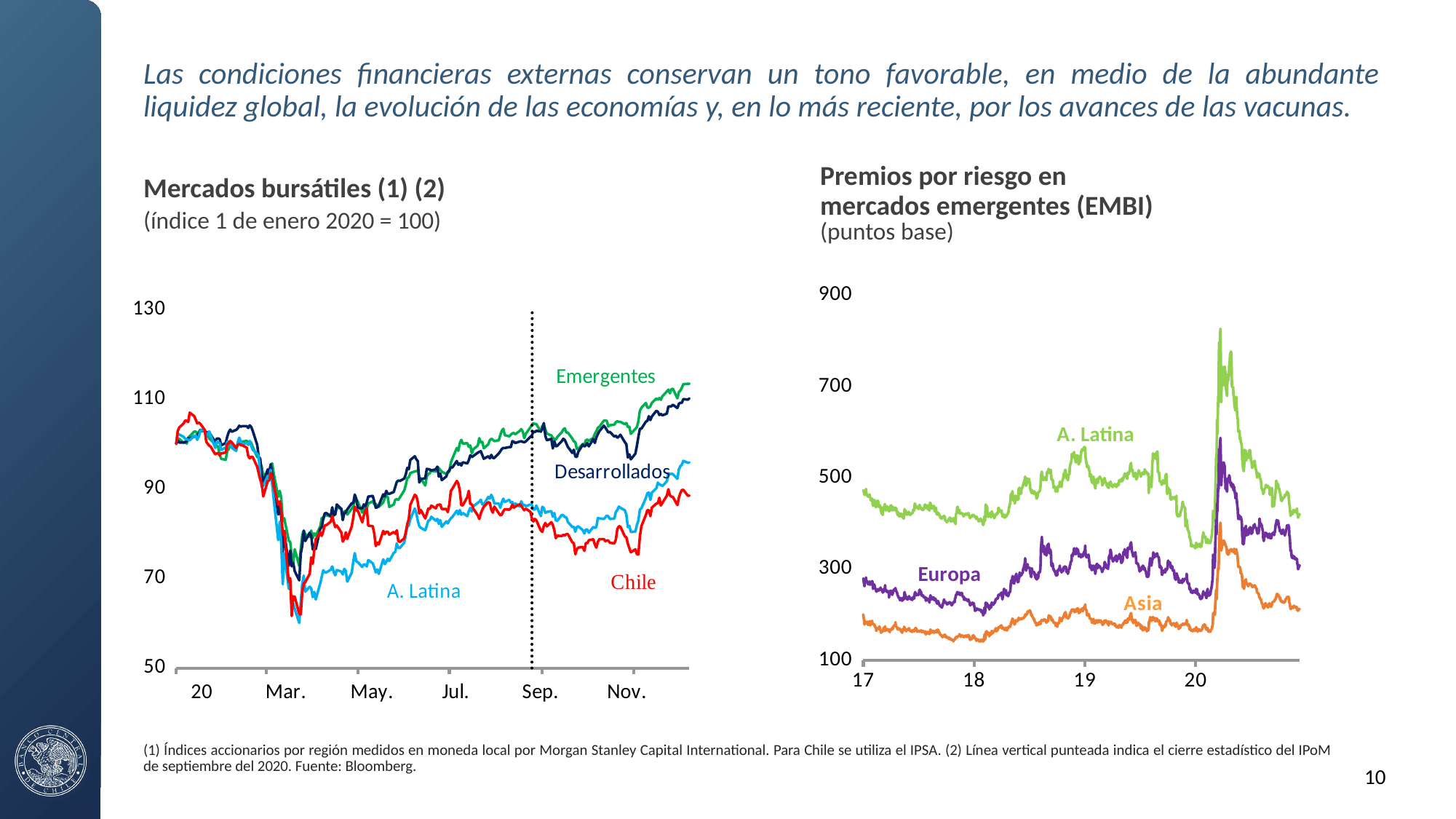
On the 'Premios por riesgo en mercados emergentes (EMBI)' chart, does the A. Latina series rise or fall from its 2020 peak to the end of the period? fall On the 'Premios por riesgo en mercados emergentes (EMBI)' chart, which series is the highest throughout the period? A. Latina What kind of chart is the 'Mercados bursátiles' chart on the left? line chart What unit is shown in the subtitle of the 'Premios por riesgo en mercados emergentes (EMBI)' chart? puntos base On the 'Mercados bursátiles' chart, which series is the highest at the end of the period (Nov.)? Emergentes On the 'Premios por riesgo en mercados emergentes (EMBI)' chart, which series is the lowest at the end of the period? Asia On the 'Mercados bursátiles' chart, is the lowest value reached by A. Latina in March greater or less than 70? less How many series are plotted on the 'Premios por riesgo en mercados emergentes (EMBI)' chart on the right? 3 On the 'Premios por riesgo en mercados emergentes (EMBI)' chart, is the peak value for A. Latina in 2020 greater or less than 700? greater How many series are plotted on the 'Mercados bursátiles' chart on the left? 4 On the 'Mercados bursátiles' chart, which series is the lowest at the end of the period (Nov.)? Chile On the 'Mercados bursátiles' chart, is the value for Emergentes at the end of the period greater or less than 100? greater